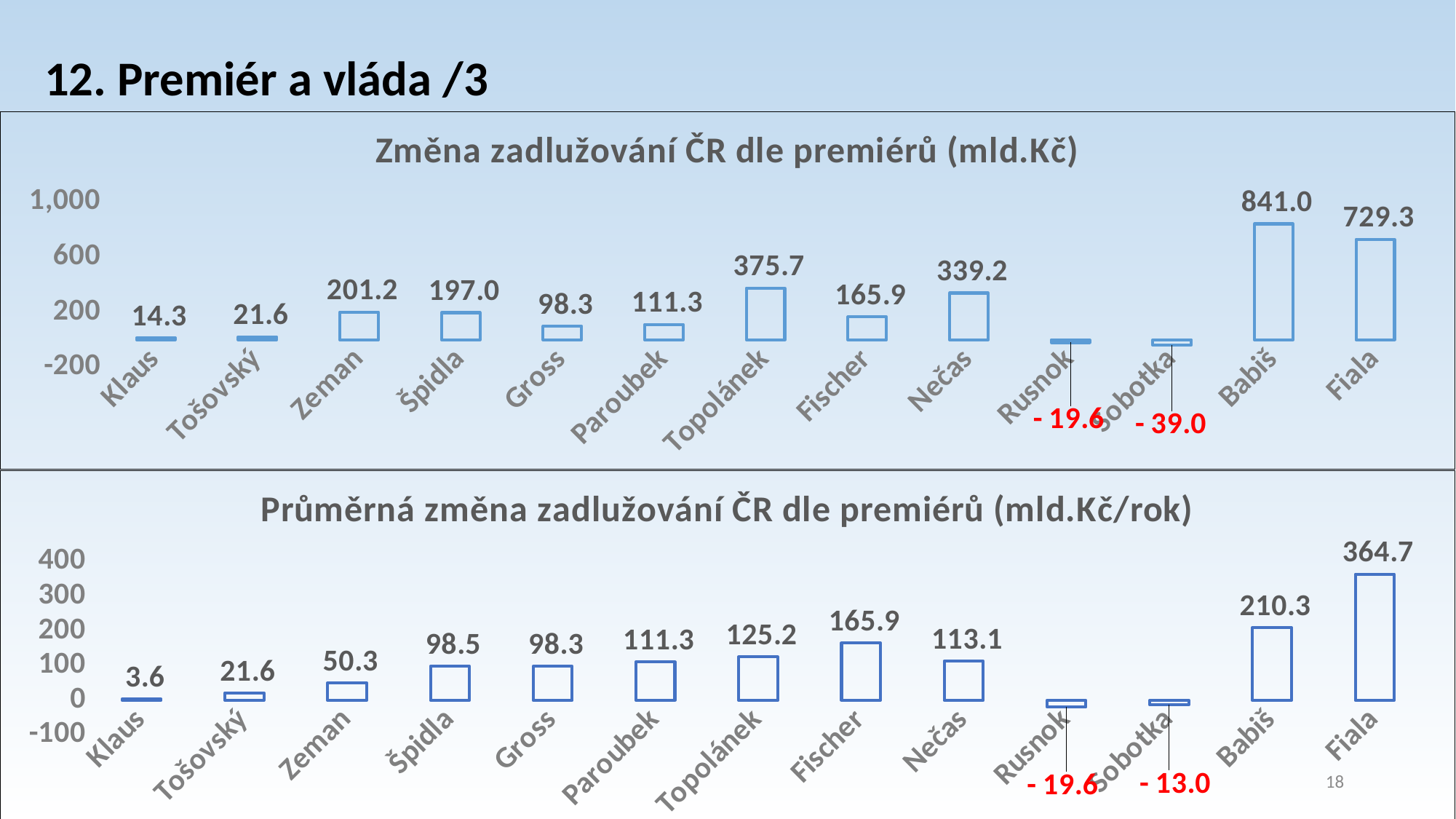
What type of chart is the bottom chart 'Průměrná změna zadlužování ČR dle premiérů (mld.Kč/rok)'? bar chart In the bottom chart 'Průměrná změna zadlužování ČR dle premiérů (mld.Kč/rok)', which premier has the highest value? Fiala In the bottom chart 'Průměrná změna zadlužování ČR dle premiérů (mld.Kč/rok)', what is the value for Fiala? 364.7 In the top chart 'Změna zadlužování ČR dle premiérů (mld.Kč)', which premier has the lowest value? Sobotka In the top chart 'Změna zadlužování ČR dle premiérů (mld.Kč)', what is the difference between the values for Babiš and Fiala? 111.7 In the bottom chart 'Průměrná změna zadlužování ČR dle premiérů (mld.Kč/rok)', what is the difference between the values for Fiala and Babiš? 154.4 In the top chart 'Změna zadlužování ČR dle premiérů (mld.Kč)', what is the value for Babiš? 841.0 In the bottom chart 'Průměrná změna zadlužování ČR dle premiérů (mld.Kč/rok)', what is the value for Sobotka? - 13.0 In the bottom chart 'Průměrná změna zadlužování ČR dle premiérů (mld.Kč/rok)', which is larger, the value for Fischer or the value for Nečas? Fischer In the top chart 'Změna zadlužování ČR dle premiérů (mld.Kč)', which premier has the highest value? Babiš How many premiers are shown in the top chart 'Změna zadlužování ČR dle premiérů (mld.Kč)'? 13 In the top chart 'Změna zadlužování ČR dle premiérů (mld.Kč)', which is larger, the value for Topolánek or the value for Nečas? Topolánek